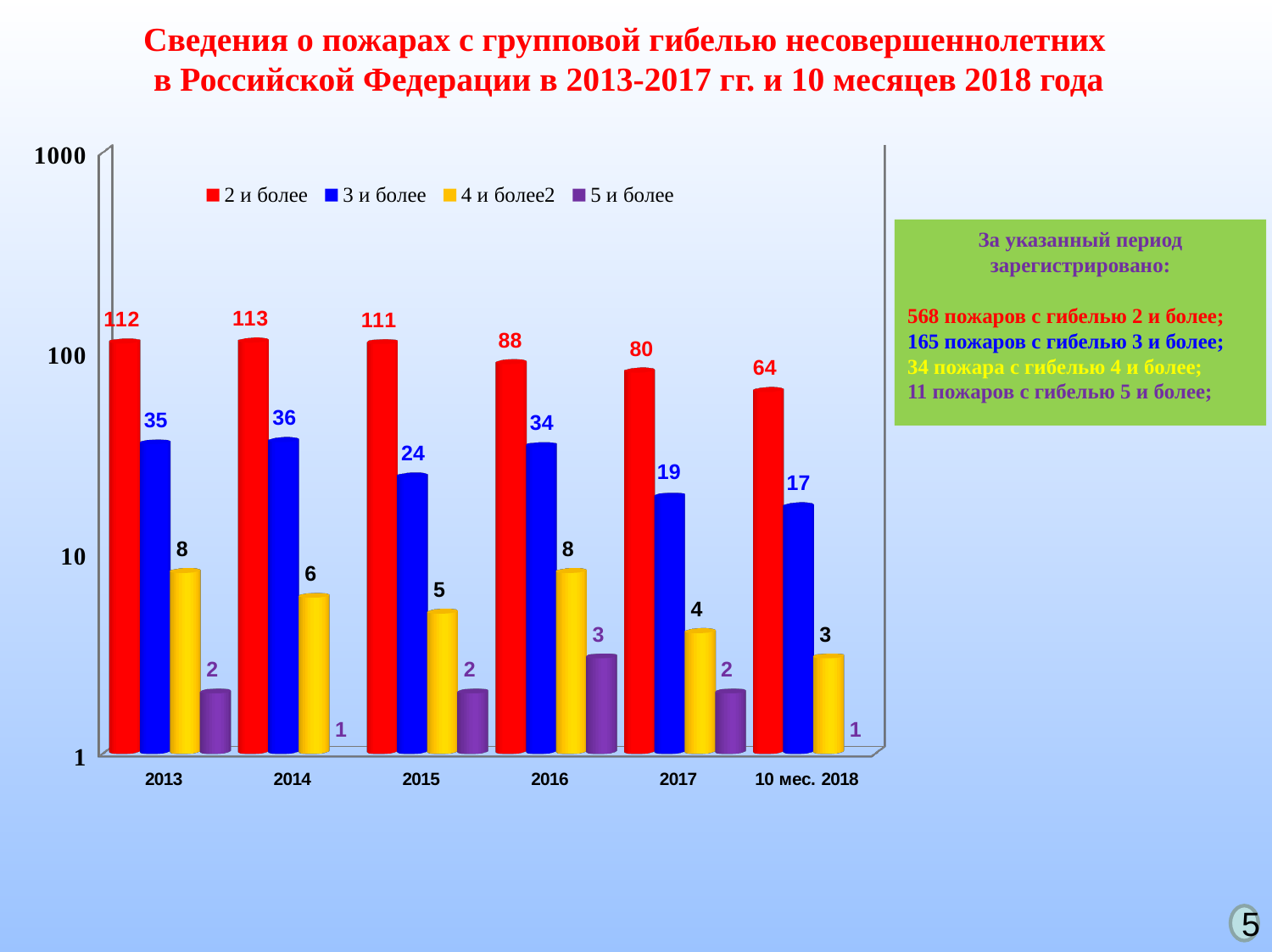
Does the "2 и более" series rise or fall from 2015 to 10 мес. 2018? fall What is the difference between the "2 и более" values for 2013 and 10 мес. 2018? 48 In which category is the "3 и более" series lowest? 10 мес. 2018 What kind of chart is shown on the slide? bar chart Which is larger: the "3 и более" value in 2014 or in 2016? 2014 What is the value for "3 и более" in 2015? 24 What is the value for "5 и более" in 2016? 3 How many series does the legend list? 4 What is the value for "2 и более" in 2016? 88 What is the value for "4 и более2" in 2017? 4 How many categories are shown on the x axis? 6 In which year is the "2 и более" series highest? 2014